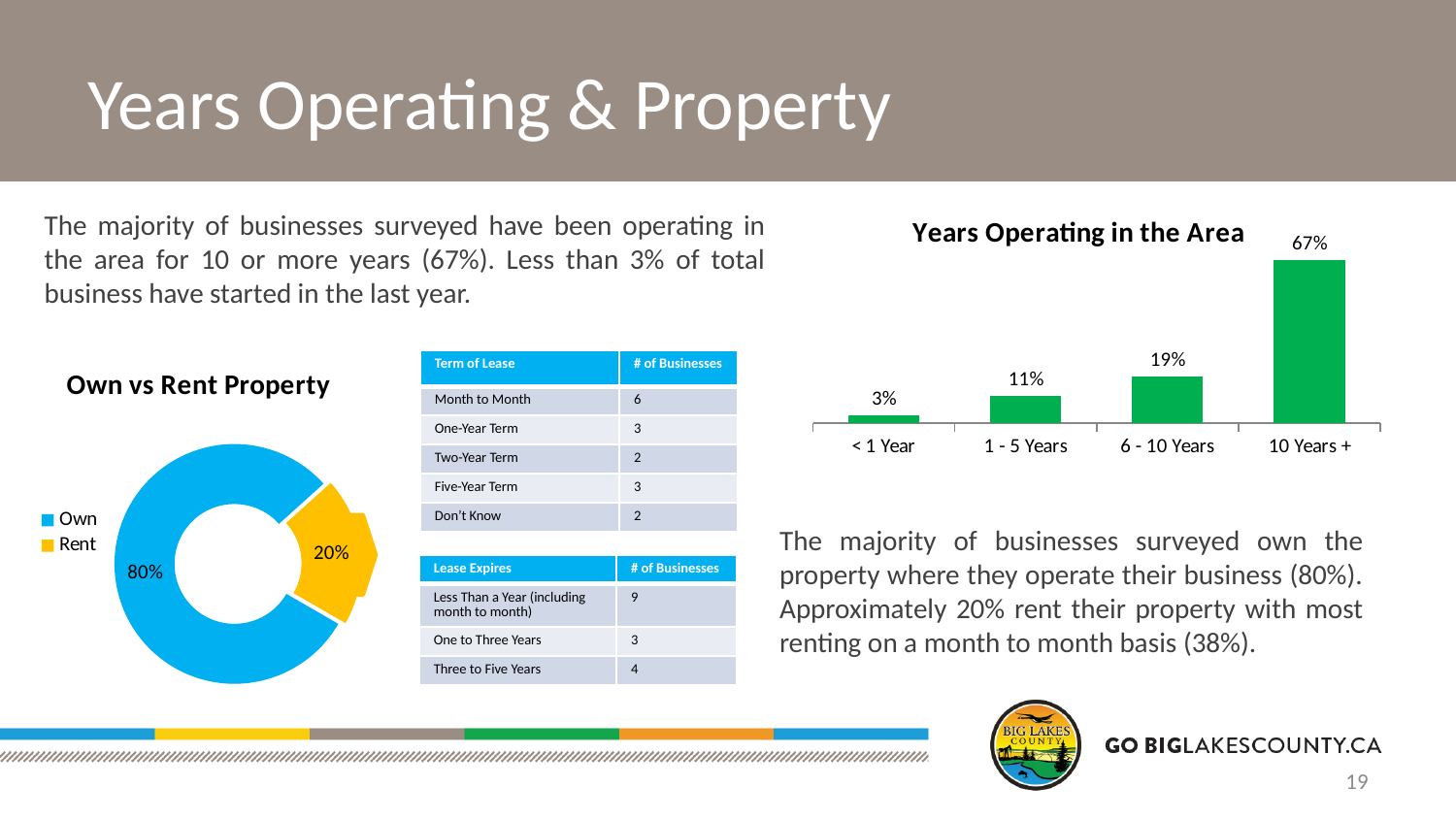
Do the values in the 'Years Operating in the Area' chart rise or fall from left to right? rise In the 'Own vs Rent Property' chart, what is the value for 'Own'? 80% In the 'Years Operating in the Area' chart, what is the value for '1 - 5 Years'? 11% How many entries does the legend of the 'Own vs Rent Property' chart list? 2 In the 'Years Operating in the Area' chart, which is larger: '6 - 10 Years' or '1 - 5 Years'? 6 - 10 Years In the 'Years Operating in the Area' chart, what is the difference between '10 Years +' and '6 - 10 Years'? 48% In the 'Years Operating in the Area' chart, which category has the highest value? 10 Years + What kind of chart is 'Years Operating in the Area'? bar chart In the 'Years Operating in the Area' chart, which category has the lowest value? < 1 Year In the 'Years Operating in the Area' chart, what is the value for '10 Years +'? 67% In the 'Own vs Rent Property' chart, what share of the pie is 'Rent'? 20% How many categories are shown in the 'Years Operating in the Area' chart? 4